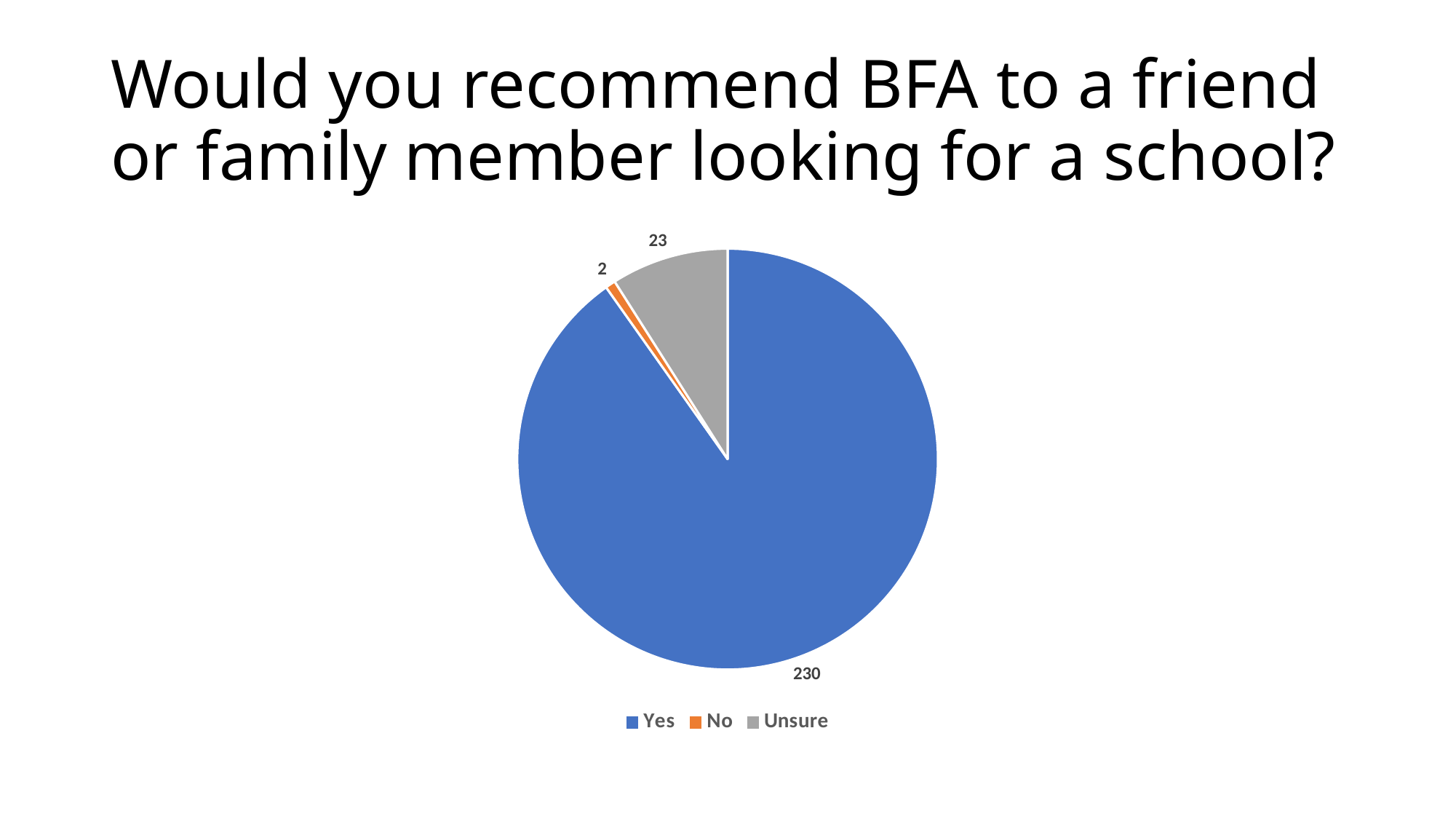
Which is larger, the number of Unsure responses or the number of No responses? Unsure How many respondents answered Yes? 230 How many response categories does the pie chart show? 3 How many respondents answered No? 2 What is the difference between the number of Unsure responses and the number of No responses? 21 Which response has the smallest slice of the pie? No What is the difference between the number of Yes responses and the number of Unsure responses? 207 What is the total number of responses across all slices of the pie? 255 Which colour represents the Unsure slice in the pie chart? Grey How many respondents answered Unsure? 23 What kind of chart is shown on the slide? Pie chart Which response has the largest slice of the pie? Yes